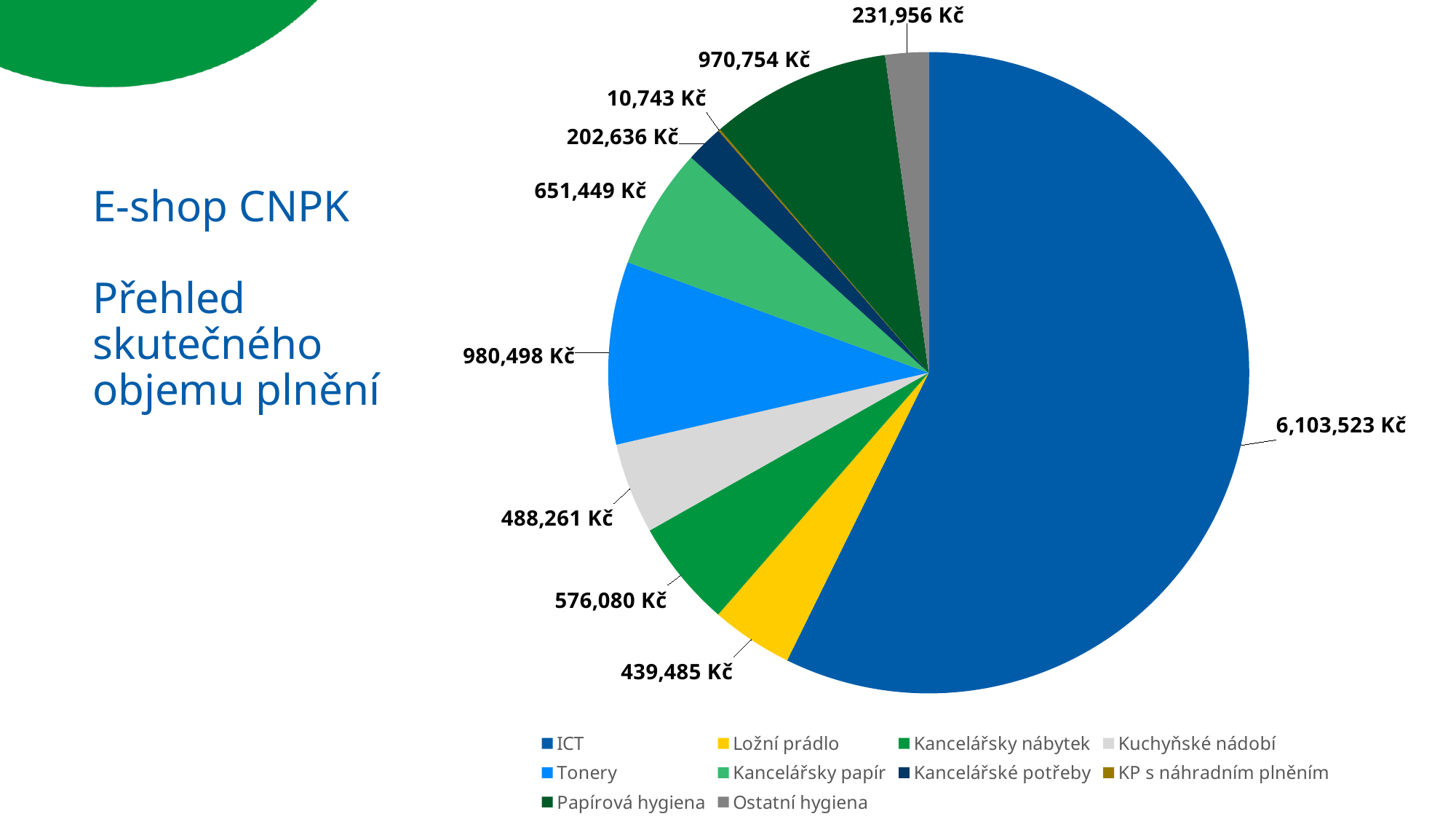
What is the value for Papírová hygiena? 970,754 Kč Which is larger, Kancelářsky papír or Kancelářsky nábytek? Kancelářsky papír What is the value for Kuchyňské nádobí? 488,261 Kč What is the value for Tonery? 980,498 Kč Which category has the largest slice? ICT Which category has the smallest slice? KP s náhradním plněním What colour is the slice for Ložní prádlo? yellow How many categories does the pie chart have? 10 What is the value for ICT? 6,103,523 Kč What is the value for KP s náhradním plněním? 10,743 Kč What is the difference between the values for Tonery and Papírová hygiena? 9,744 Kč What type of chart is shown on the slide? pie chart